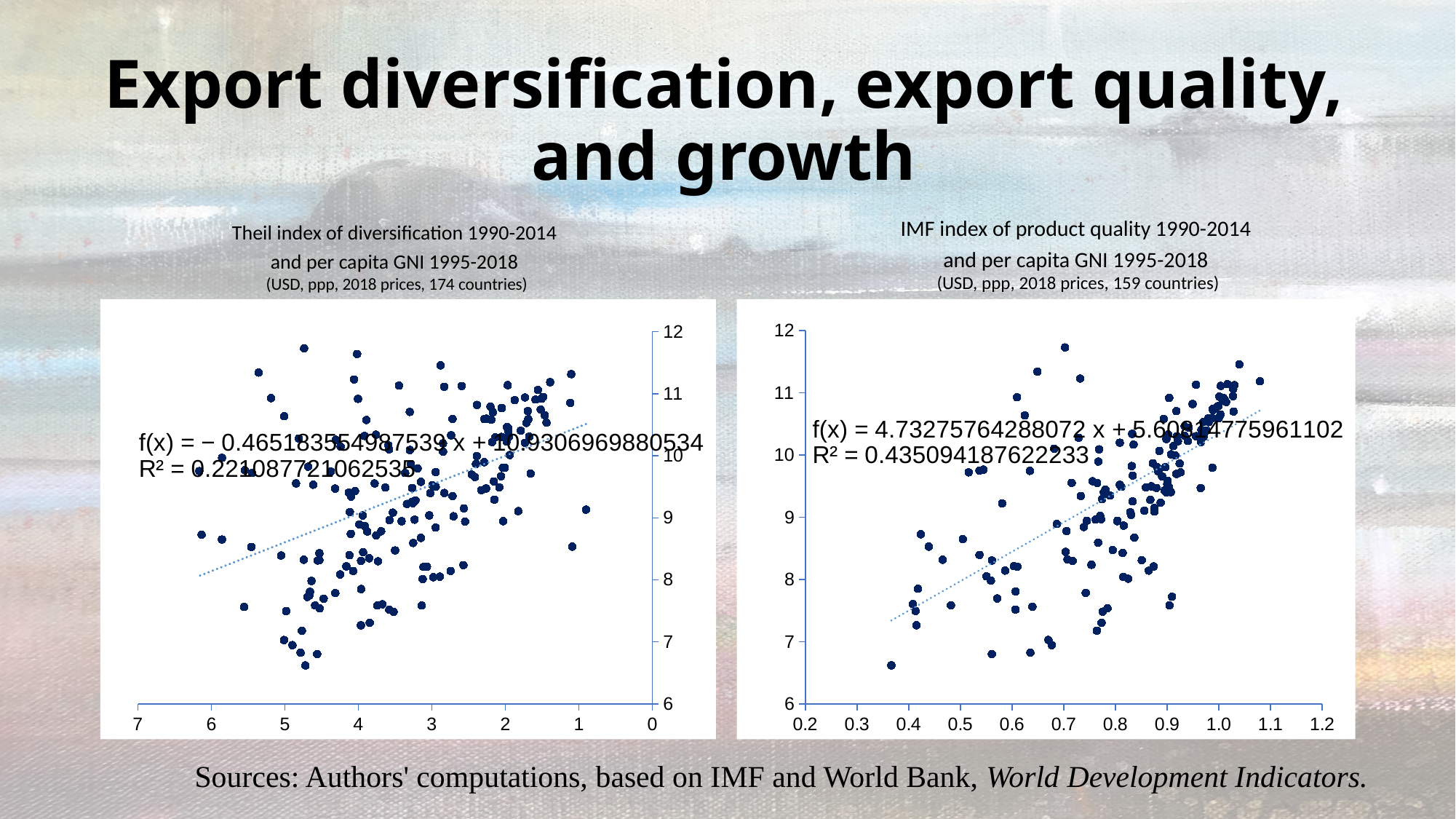
In the right chart (IMF index of product quality), what is the slope of the fitted line f(x)? 4.73275764288072 In the right chart (IMF index of product quality), do the plotted values tend to rise or fall as the index increases along the x axis? Rise In the right chart (IMF index of product quality), is the lowest plotted y value greater or less than 7? less In the left chart (Theil index of diversification), what is the slope of the fitted line f(x)? −0.465183554987539 In the left chart (Theil index of diversification), does the trend line rise or fall moving from left to right across the chart? Rise In the right chart (IMF index of product quality), is the highest plotted y value greater or less than 11? greater What kind of chart is the left chart, 'Theil index of diversification 1990-2014 and per capita GNI 1995-2018'? Scatter chart How many countries are included in the left chart (Theil index of diversification)? 174 countries How many countries are included in the right chart (IMF index of product quality)? 159 countries What kind of chart is the right chart, 'IMF index of product quality 1990-2014 and per capita GNI 1995-2018'? Scatter chart In the right chart (IMF index of product quality), what is the R² value shown for the trend line? 0.435094187622233 Which chart shows the higher R² for its trend line, the left (Theil index) or the right (IMF index of product quality)? The right chart (IMF index of product quality)